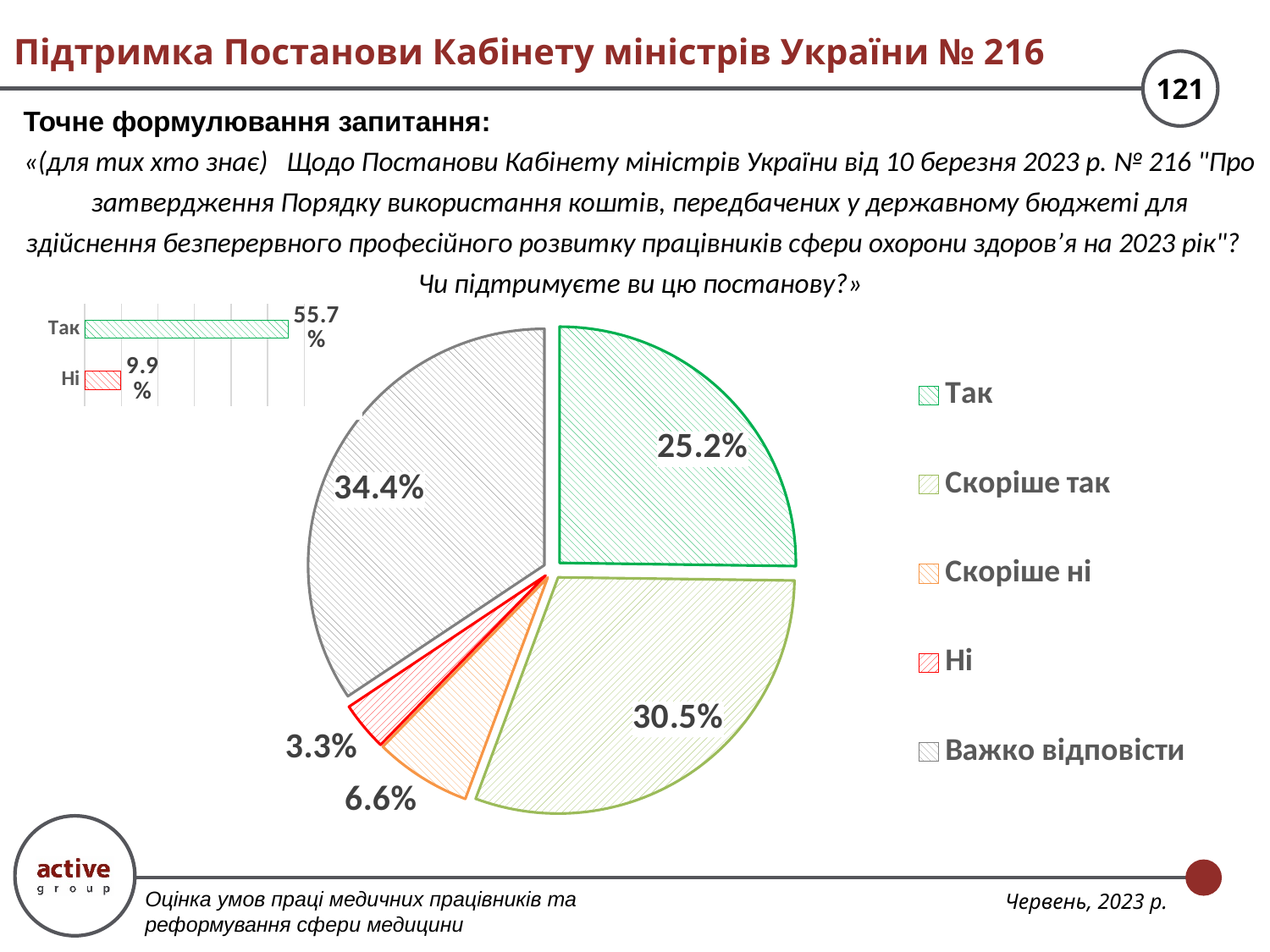
In the pie chart, what share is shown for "Скоріше так"? 30.5% What kind of chart is the large chart in the centre of the slide? Pie chart In the small bar chart at the top left, what value is shown for "Так"? 55.7% In the small bar chart at the top left, what is the difference between the values for "Так" and "Ні"? 45.8% In the pie chart, which is larger: the share for "Скоріше ні" or the share for "Ні"? Скоріше ні In the pie chart, what share is shown for "Важко відповісти"? 34.4% In the pie chart, what is the difference between the shares for "Скоріше так" and "Так"? 5.3% In the pie chart, what share is shown for "Так"? 25.2% In the pie chart, which category has the largest slice? Важко відповісти In the pie chart, which category has the smallest slice? Ні How many categories does the pie chart's legend list? 5 In the small bar chart at the top left, what value is shown for "Ні"? 9.9%